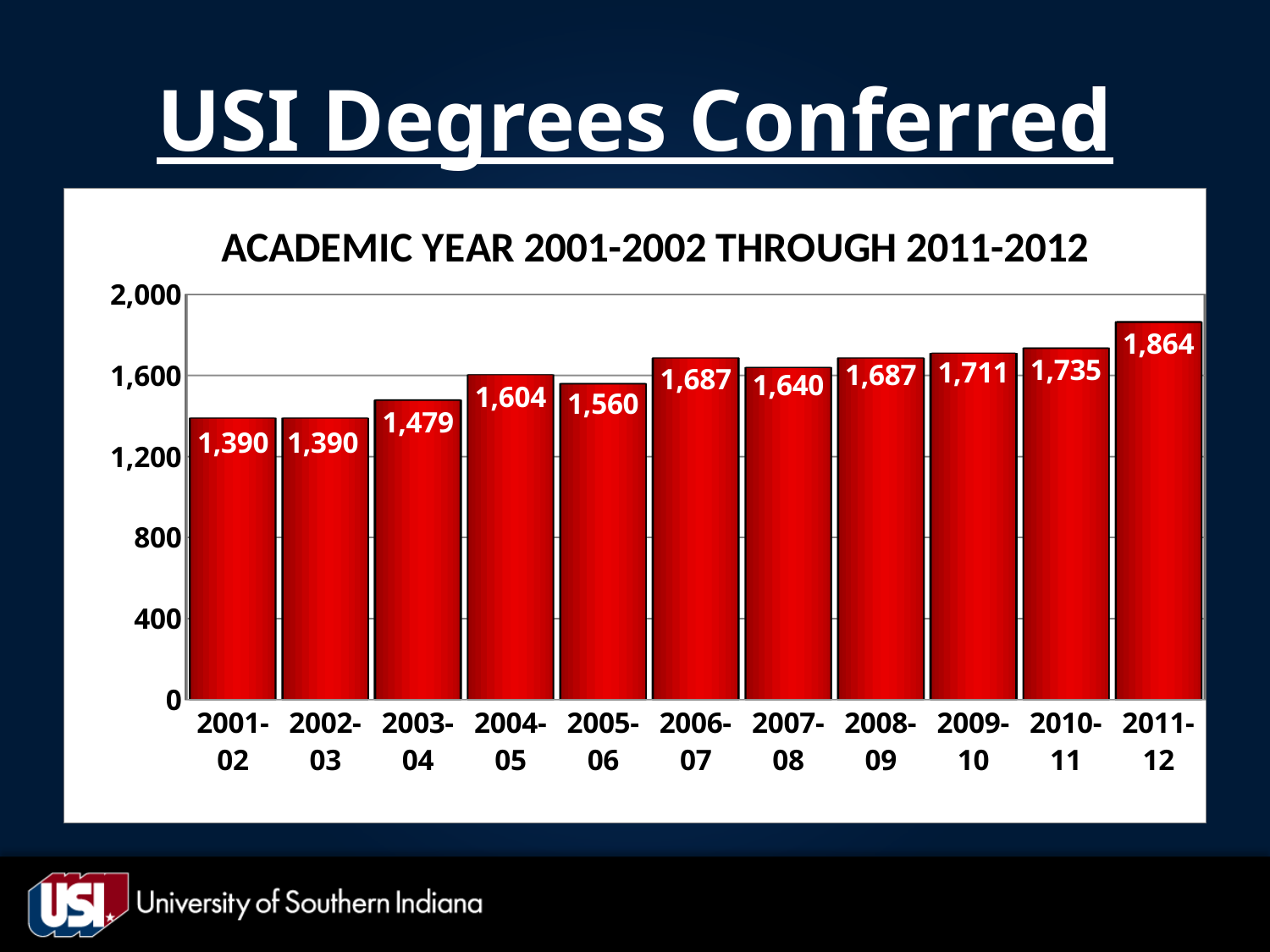
What kind of chart is shown on the slide? bar chart What is the value for 2005-06? 1,560 Which academic year has the highest number of degrees conferred? 2011-12 Which is larger, the value for 2007-08 or the value for 2008-09? 2008-09 What is the difference between the values for 2004-05 and 2005-06? 44 What is the chart's title? ACADEMIC YEAR 2001-2002 THROUGH 2011-2012 Is the value for 2009-10 greater or less than 1,600? greater What is the difference between the values for 2011-12 and 2010-11? 129 How many academic years are shown on the x axis? 11 Do the values generally rise or fall from 2001-02 to 2011-12? rise How many degrees were conferred in 2011-12? 1,864 What is the value for 2003-04? 1,479